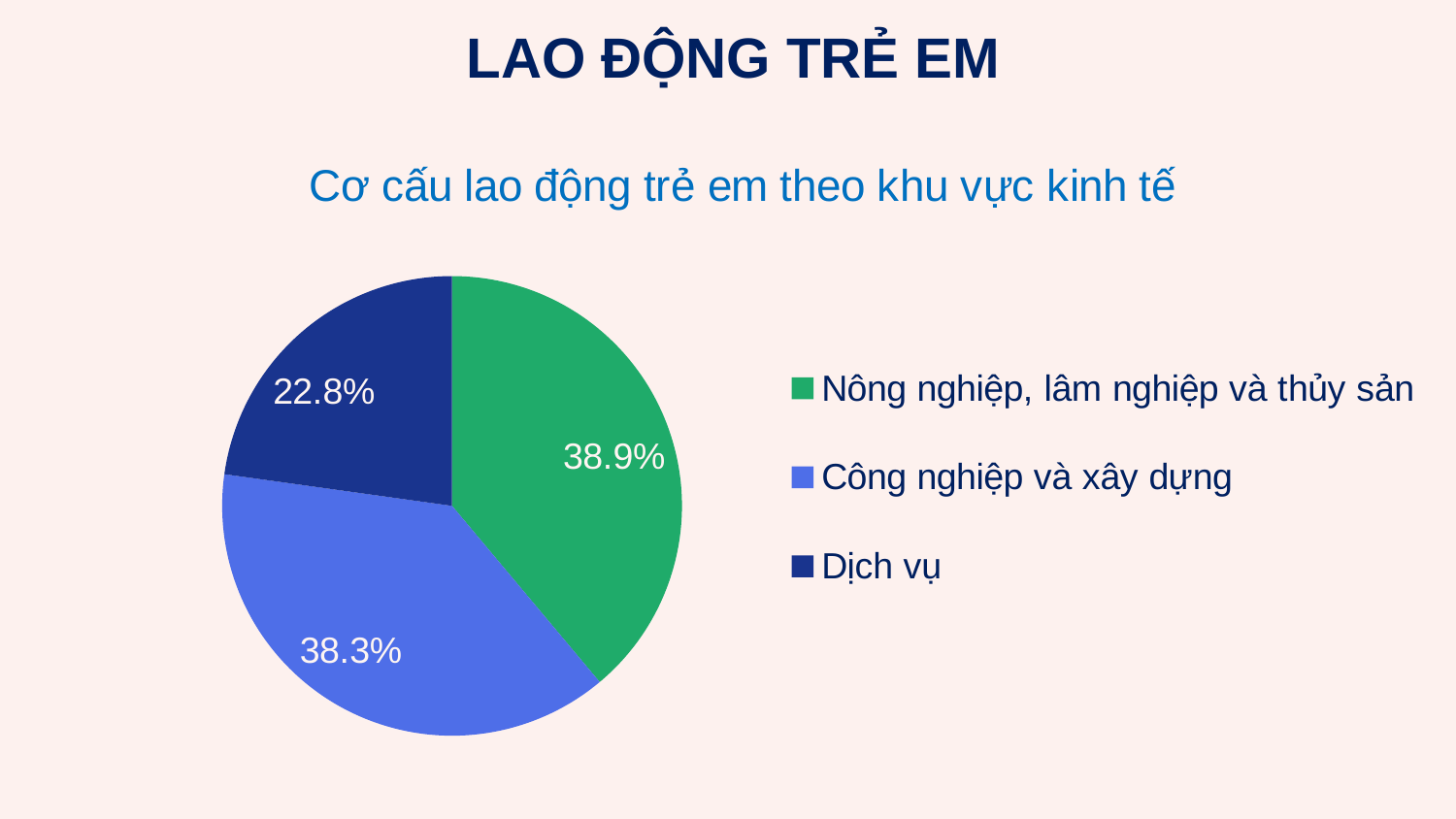
Which colour represents Dịch vụ in the chart? Dark blue Which category has the smallest slice? Dịch vụ What kind of chart is shown on the slide? Pie chart Which is larger, Công nghiệp và xây dựng or Dịch vụ? Công nghiệp và xây dựng What is the value for Dịch vụ? 22.8% How many entries does the legend list? 3 What is the title of the chart? Cơ cấu lao động trẻ em theo khu vực kinh tế Which category has the largest slice? Nông nghiệp, lâm nghiệp và thủy sản How many slices does the pie chart have? 3 What is the value for Công nghiệp và xây dựng? 38.3% What is the difference between Nông nghiệp, lâm nghiệp và thủy sản and Dịch vụ? 16.1 percentage points What share of the pie is Nông nghiệp, lâm nghiệp và thủy sản? 38.9%